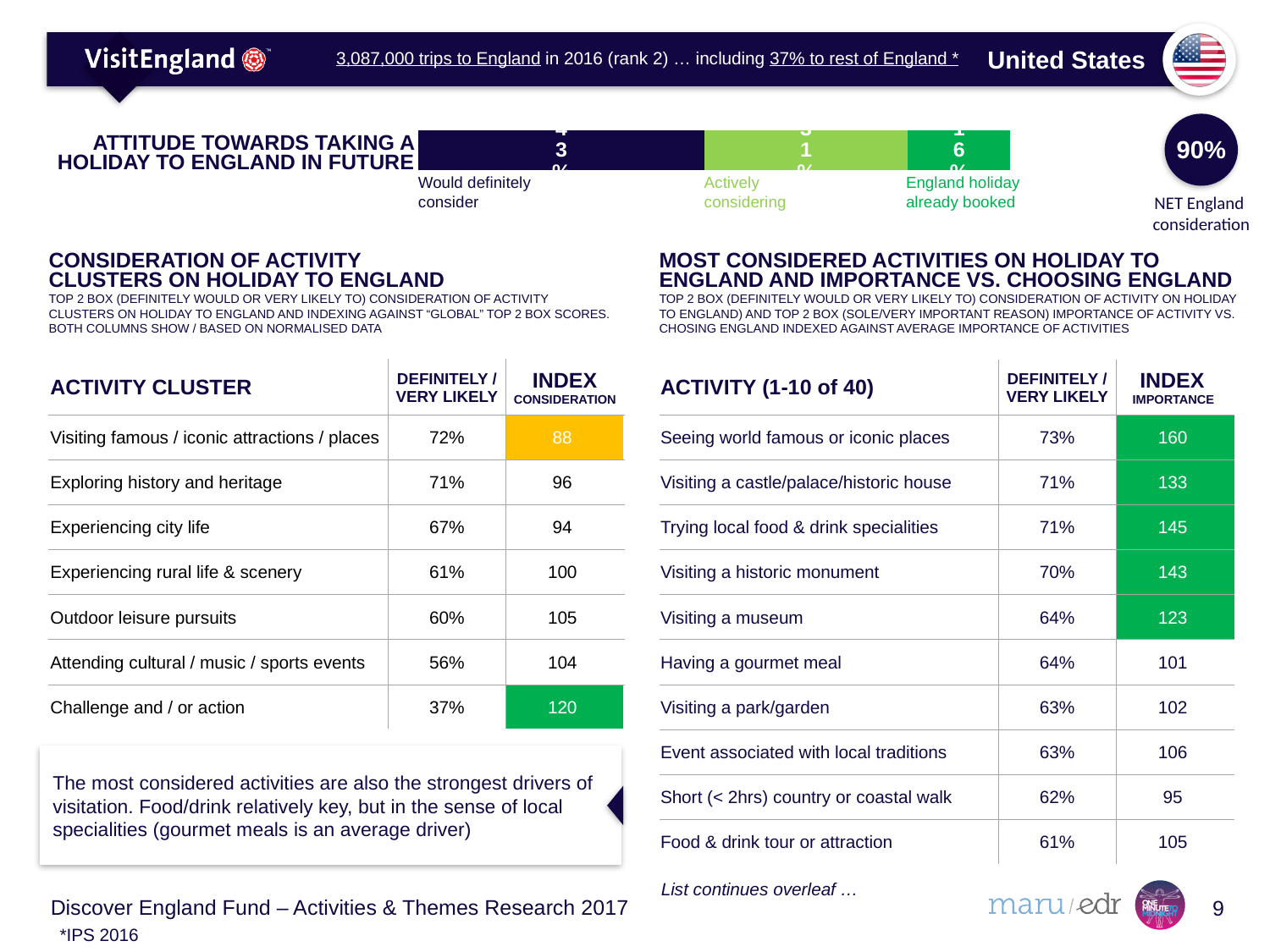
In the 'Attitude towards taking a holiday to England in future' chart, what is the difference between 'Would definitely consider' and 'England holiday already booked'? 27% What kind of chart is the 'Attitude towards taking a holiday to England in future' chart? bar chart In the 'Attitude towards taking a holiday to England in future' chart, which segment has the lowest value? England holiday already booked What value is shown in the circle labelled 'NET England consideration' next to the 'Attitude towards taking a holiday to England in future' chart? 90% In the 'Attitude towards taking a holiday to England in future' chart, what is the total of the three segments of the stacked bar? 90% In the 'Attitude towards taking a holiday to England in future' chart, what is the value for 'Would definitely consider'? 43% In the 'Attitude towards taking a holiday to England in future' chart, what colour is the 'Would definitely consider' segment? dark navy blue In the 'Attitude towards taking a holiday to England in future' chart, which is larger: 'Would definitely consider' or 'Actively considering'? Would definitely consider In the 'Attitude towards taking a holiday to England in future' chart, which segment has the highest value? Would definitely consider In the 'Attitude towards taking a holiday to England in future' chart, what is the value for 'Actively considering'? 31% In the 'Attitude towards taking a holiday to England in future' chart, what is the value for 'England holiday already booked'? 16% How many segments make up the 'Attitude towards taking a holiday to England in future' bar? 3